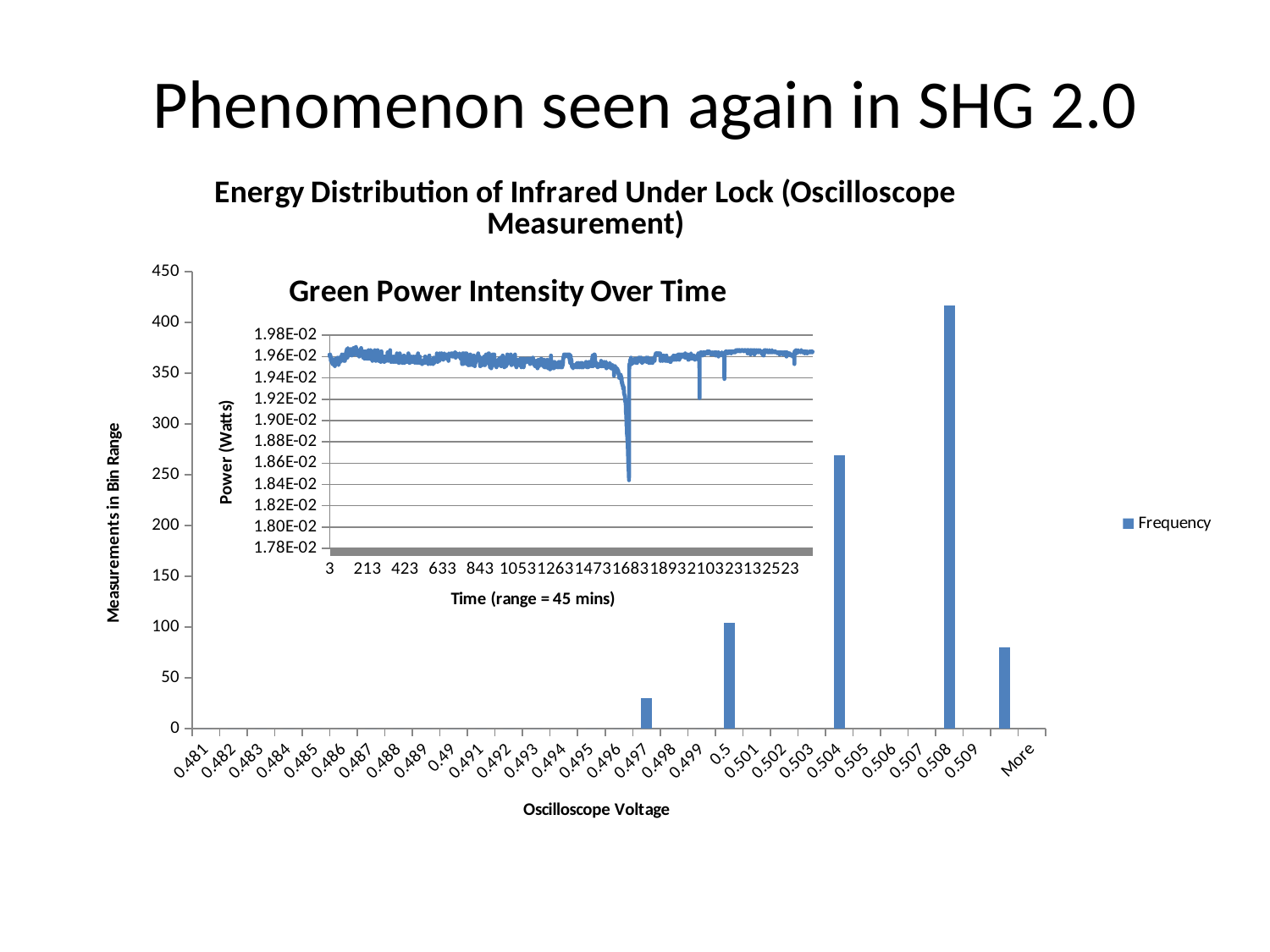
In the 'Energy Distribution of Infrared Under Lock' chart, which has the larger frequency, 0.504 or 0.5? 0.504 How many series does the legend of the 'Energy Distribution of Infrared Under Lock' chart list? 1 What kind of chart is the inset 'Green Power Intensity Over Time' chart? line chart What is the y-axis label of the 'Green Power Intensity Over Time' chart? Power (Watts) In the 'Energy Distribution of Infrared Under Lock' chart, is the value for 0.497 greater or less than 50? less In the 'Energy Distribution of Infrared Under Lock' chart, is the value for 0.508 greater or less than 350? greater What kind of chart is the 'Energy Distribution of Infrared Under Lock (Oscilloscope Measurement)' chart? bar chart What is the legend entry shown for the 'Energy Distribution of Infrared Under Lock' chart? Frequency In the 'Energy Distribution of Infrared Under Lock' chart, which oscilloscope voltage bin has the highest frequency? 0.508 In the 'Energy Distribution of Infrared Under Lock' chart, is the value for 0.5 greater or less than 150? less In the 'Energy Distribution of Infrared Under Lock' chart, how many voltage bins have a visible non-zero bar? 5